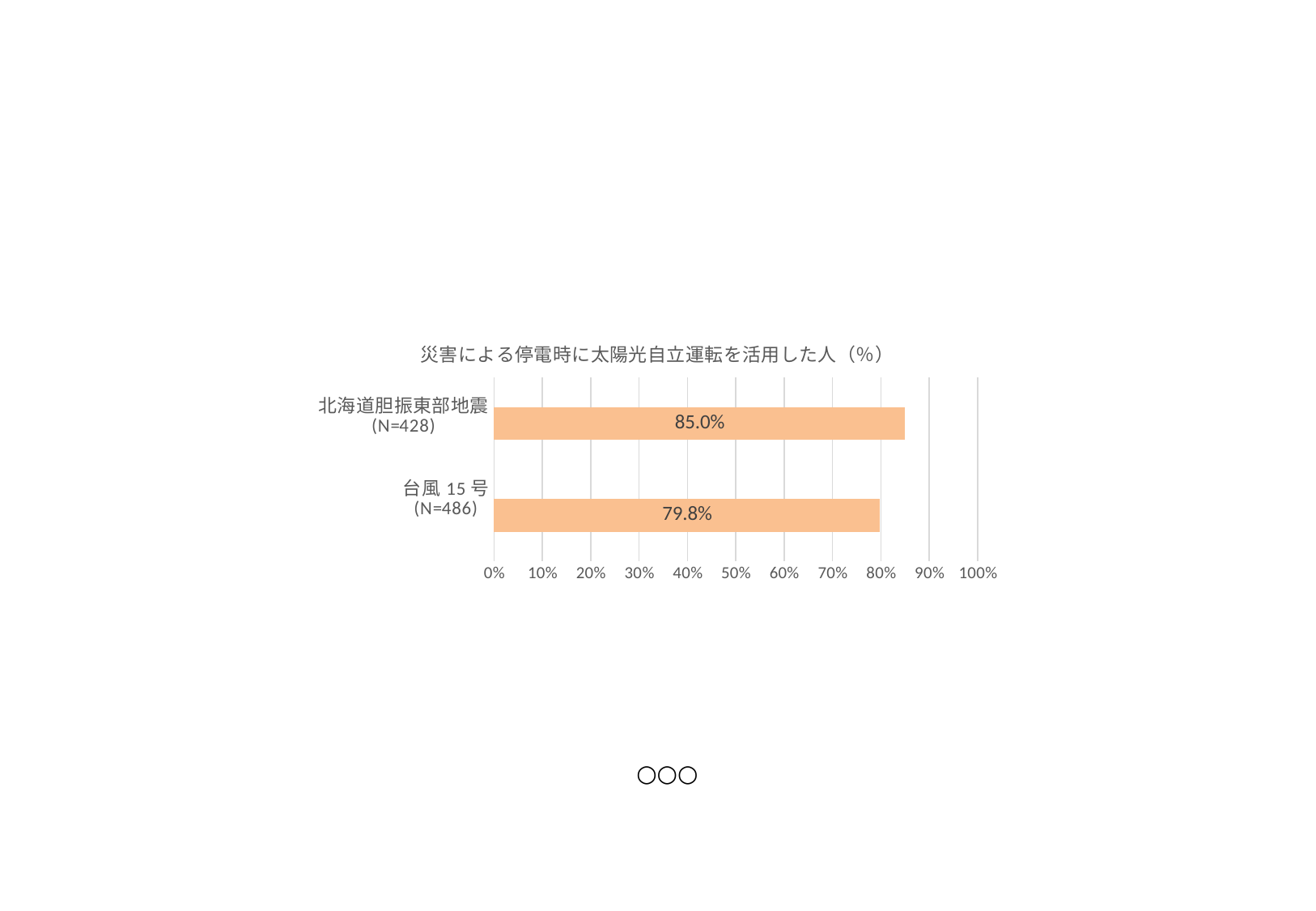
What is the maximum value shown on the x axis? 100% Is the value for 台風15号 greater or less than 80%? less Which is larger, the value for 北海道胆振東部地震 or the value for 台風15号? 北海道胆振東部地震 What is the title of the chart? 災害による停電時に太陽光自立運転を活用した人（%） Is the value for 北海道胆振東部地震 greater or less than 80%? greater How many categories are shown in the chart? 2 Which category has the highest value? 北海道胆振東部地震 (N=428) Which category has the lowest value? 台風15号 (N=486) What kind of chart is shown on the slide? bar chart What is the value for 台風15号 (N=486)? 79.8% What is the difference between the values for 北海道胆振東部地震 and 台風15号? 5.2% What is the value for 北海道胆振東部地震 (N=428)? 85.0%